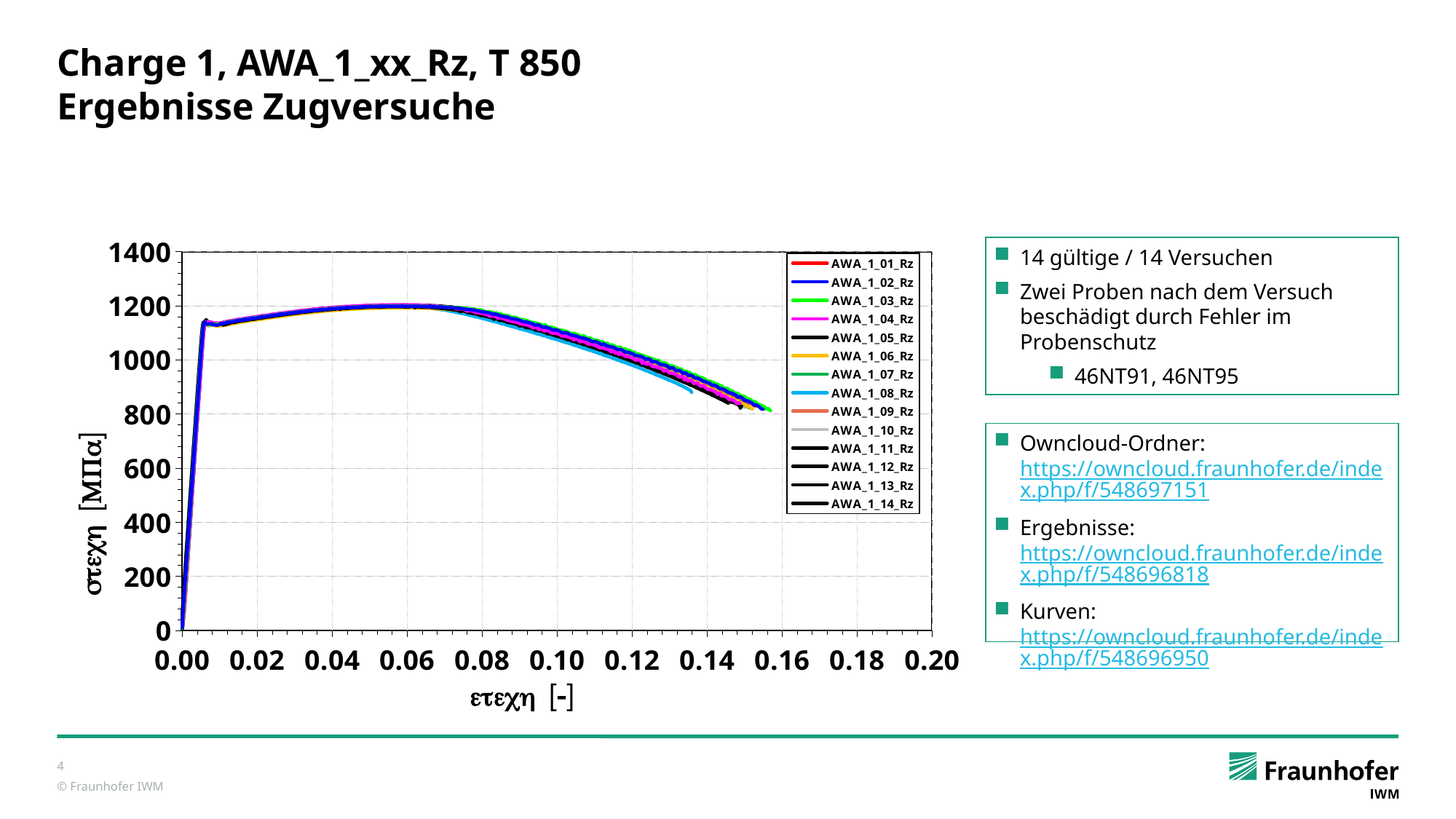
Which series ends at the smallest x-axis value? AWA_1_08_Rz How many series does the chart legend list? 14 Is the peak value reached by the curves greater or less than 1000? greater What kind of chart is shown on the slide? line chart Is the value of the curves at x = 0.04 greater or less than 1000? greater Do the curves rise or fall between x = 0.08 and x = 0.14? fall Is the peak value reached by the curves greater or less than 1400? less What is the highest tick value shown on the y axis? 1400 Do the curves rise or fall between x = 0.00 and x = 0.04? rise What is the last series listed in the chart legend? AWA_1_14_Rz What is the first series listed in the chart legend? AWA_1_01_Rz